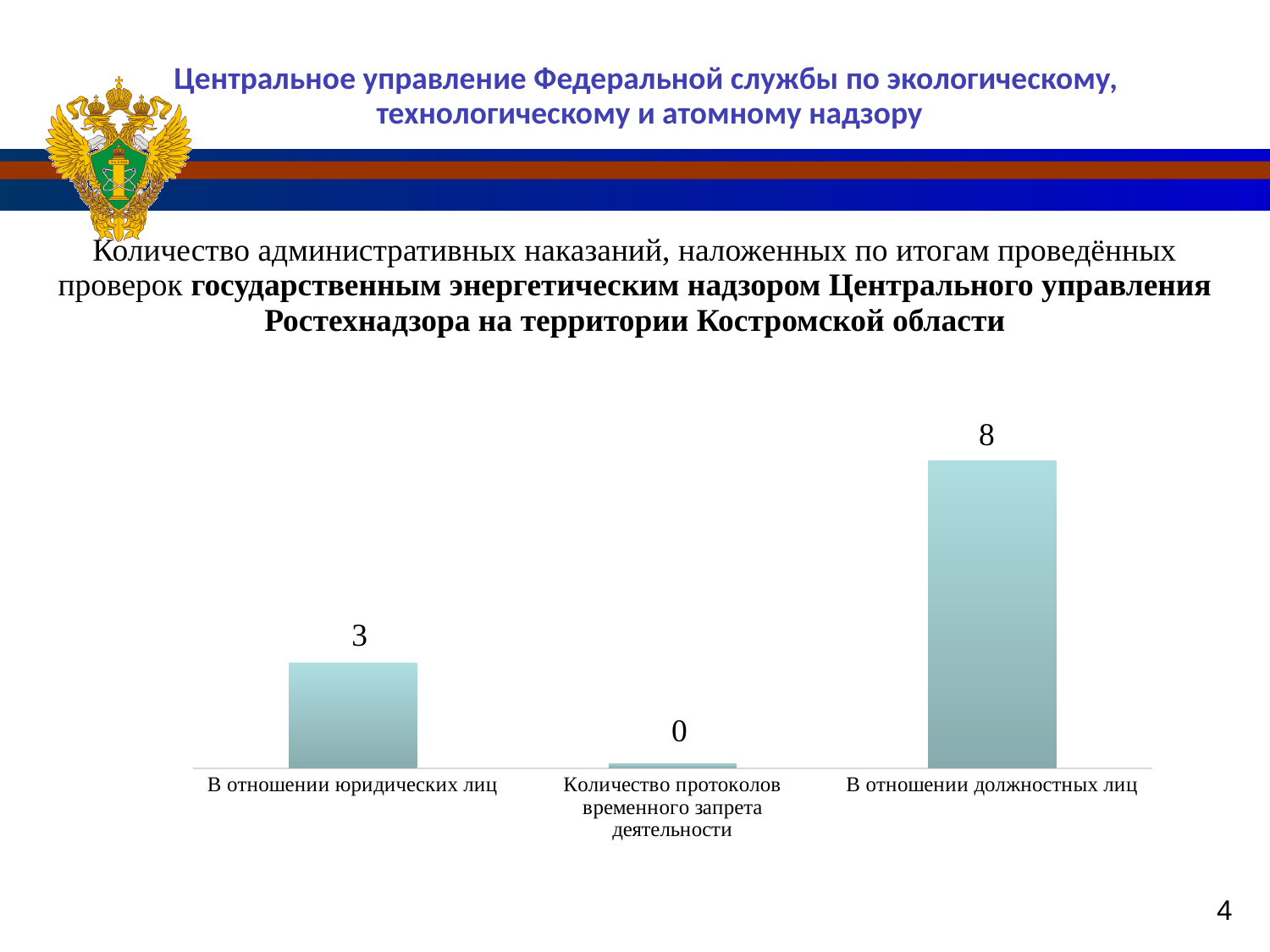
Which is larger: the value for «В отношении юридических лиц» or for «В отношении должностных лиц»? В отношении должностных лиц Which category has the lowest value? Количество протоколов временного запрета деятельности Does the chart have a legend? No Which category has the highest value? В отношении должностных лиц What is the value for «В отношении должностных лиц»? 8 What kind of chart is shown on the slide? Bar chart What is the value for «Количество протоколов временного запрета деятельности»? 0 What is the difference between the values for «В отношении должностных лиц» and «В отношении юридических лиц»? 5 What is the value for «В отношении юридических лиц»? 3 How many categories are shown in the chart? 3 What is the total of all three values shown in the chart? 11